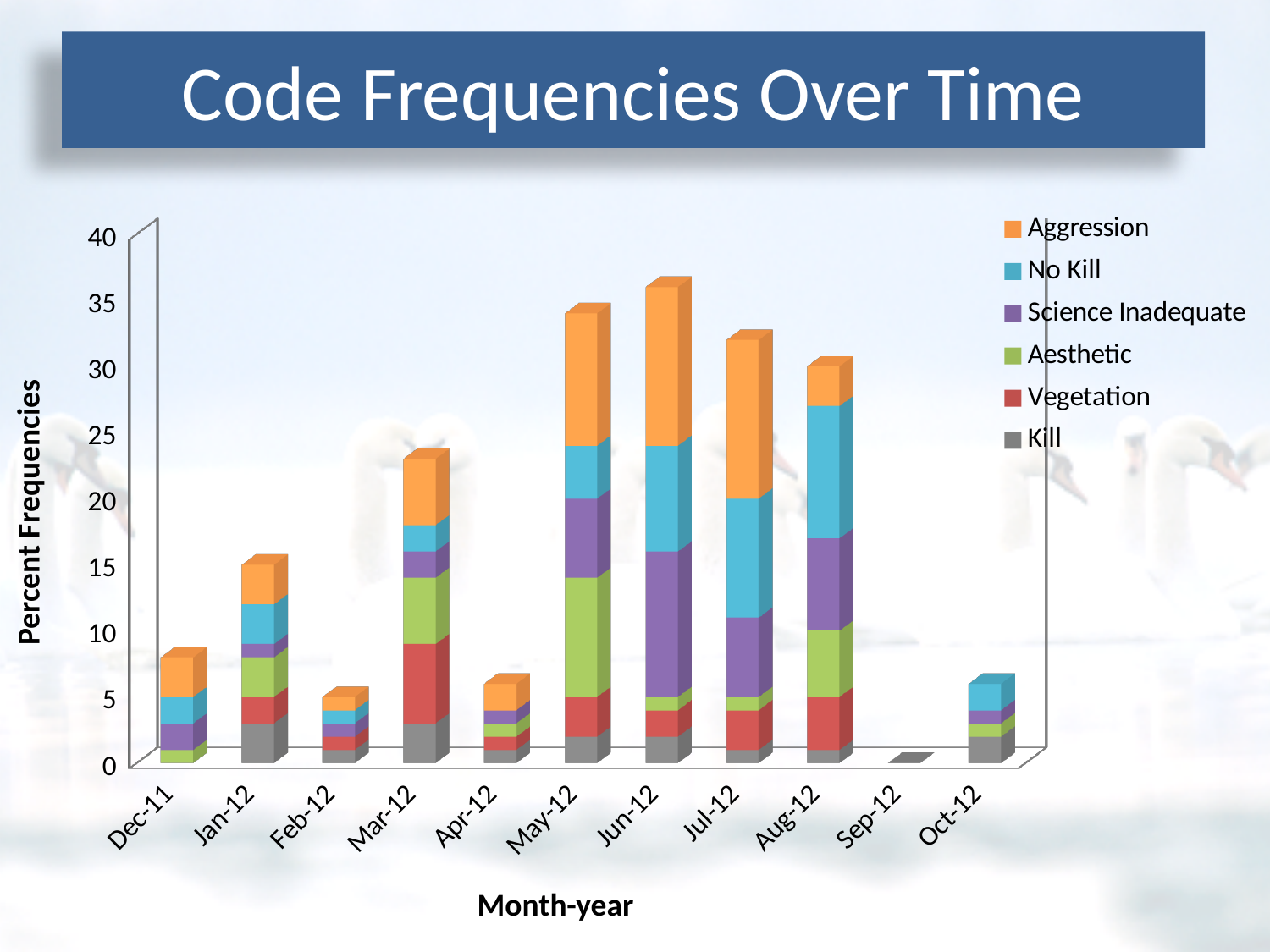
Which month has no visible bar (the lowest total)? Sep-12 Which has the larger total, Mar-12 or Jan-12? Mar-12 Do the total bar heights rise or fall from Feb-12 to Jun-12? rise Which month has the tallest stacked bar? Jun-12 What is the title of the vertical axis? Percent Frequencies Is the total value for Jun-12 greater or less than 30? greater How many month-year categories are shown on the x axis? 11 Is the total value for Mar-12 greater or less than 20? greater Is the total value for Dec-11 greater or less than 10? less What kind of chart is shown on the slide? stacked bar chart How many series does the legend list? 6